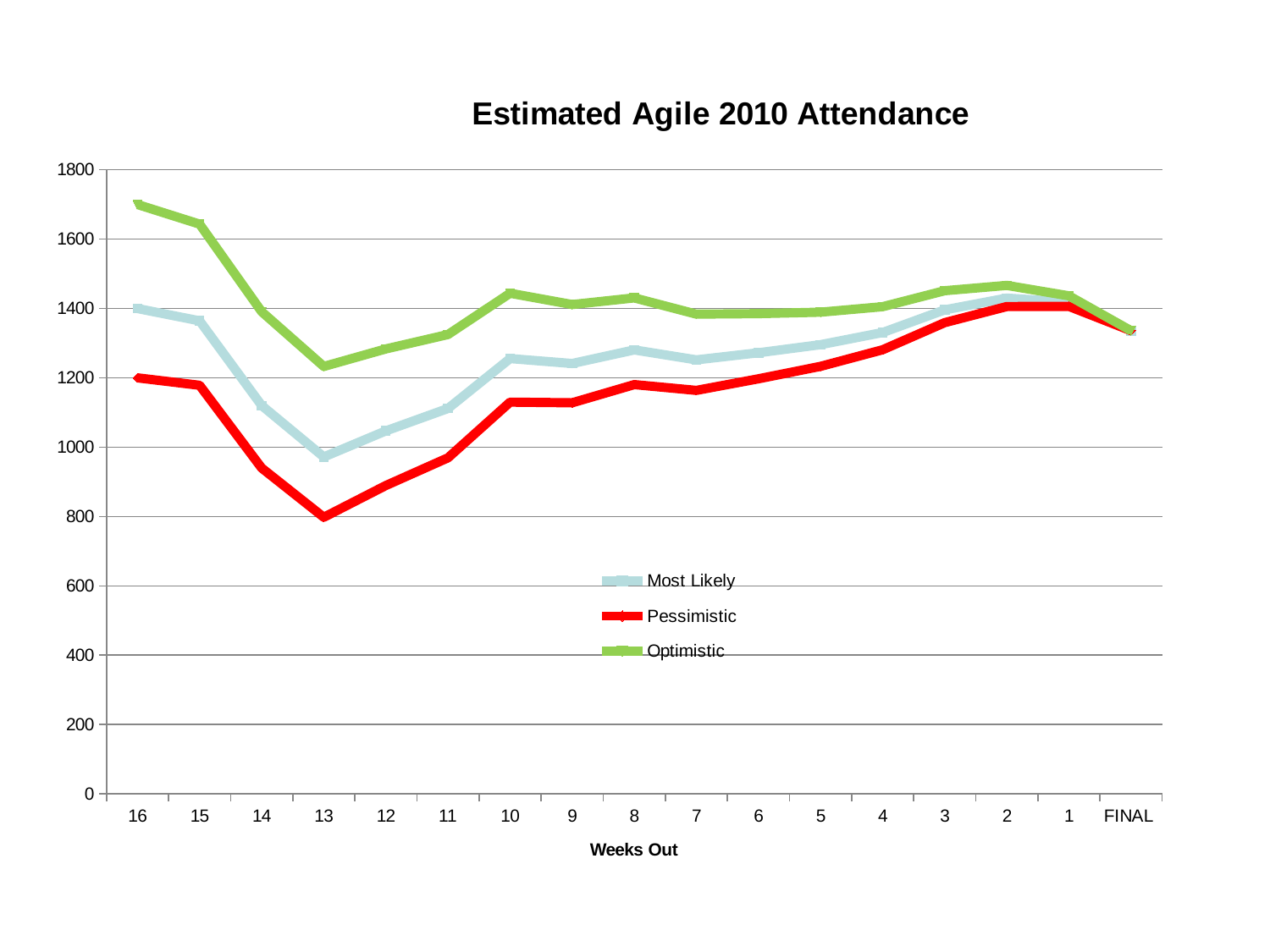
Does the Pessimistic series rise or fall from 13 weeks out to 2 weeks out? rise What is the label of the x axis? Weeks Out Is the Most Likely value at 13 weeks out greater or less than 1200? less Is the Optimistic value at 16 weeks out greater or less than 1600? greater Which series is higher at 14 weeks out, Optimistic or Pessimistic? Optimistic What kind of chart is shown on the slide? line chart How many series does the legend list? 3 At which week out does the Optimistic series reach its highest value? 16 How many points are plotted along the x axis for each series? 17 Is the Pessimistic value at 13 weeks out greater or less than 1000? less At which week out does the Pessimistic series reach its lowest value? 13 What is the title of the chart? Estimated Agile 2010 Attendance